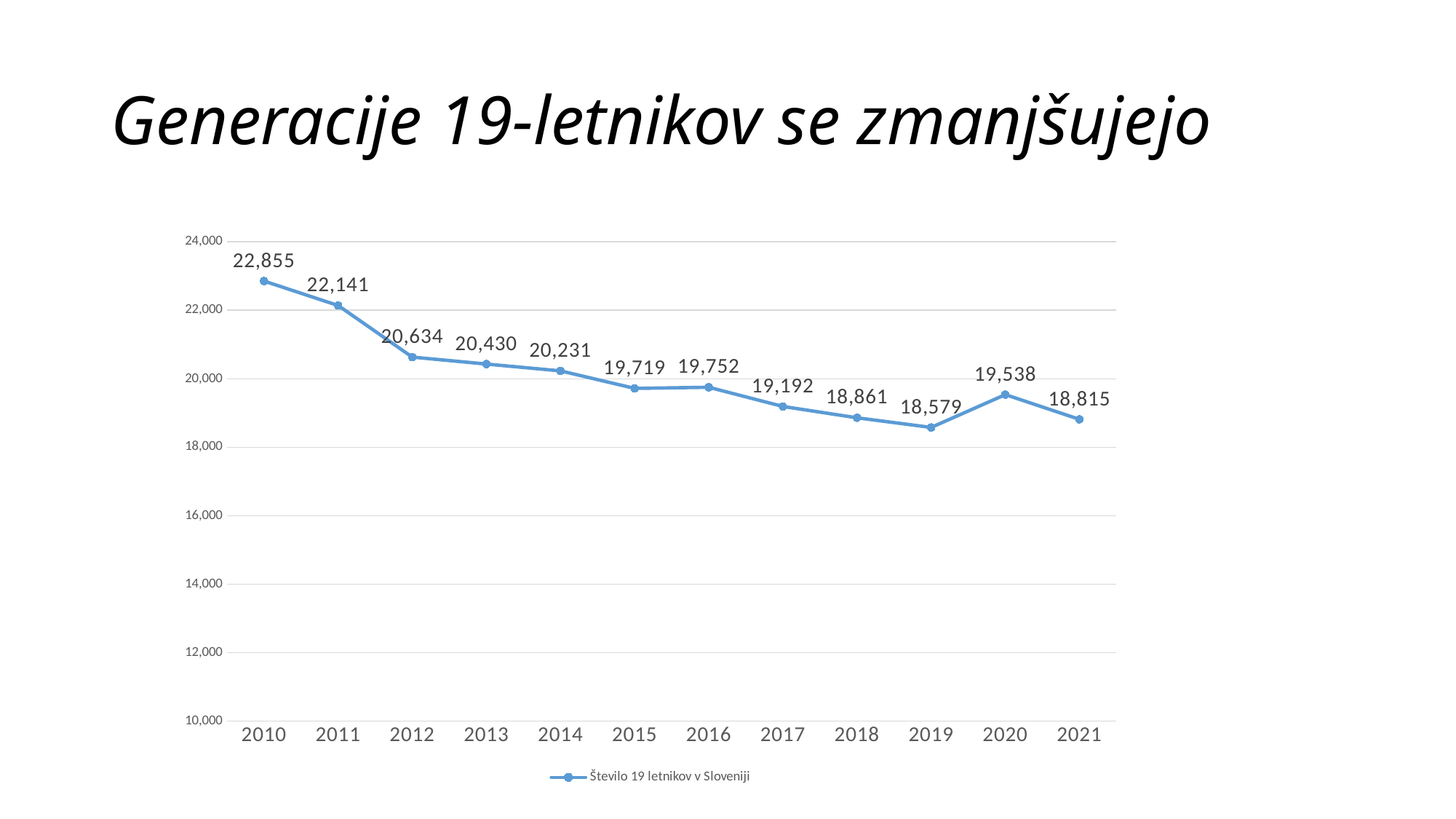
How many years are plotted on the x axis? 12 What is the value for 2019? 18,579 Which year has the lowest value? 2019 How many series does the legend list? 1 What is the value for 2021? 18,815 Which year has the highest value? 2010 What is the value for 2010? 22,855 What is the name of the series in the legend? Število 19 letnikov v Sloveniji Which is larger, the value for 2020 or the value for 2019? 2020 Is the value for 2012 greater or less than 20,000? greater What is the difference between the values for 2010 and 2021? 4,040 What kind of chart is shown? line chart